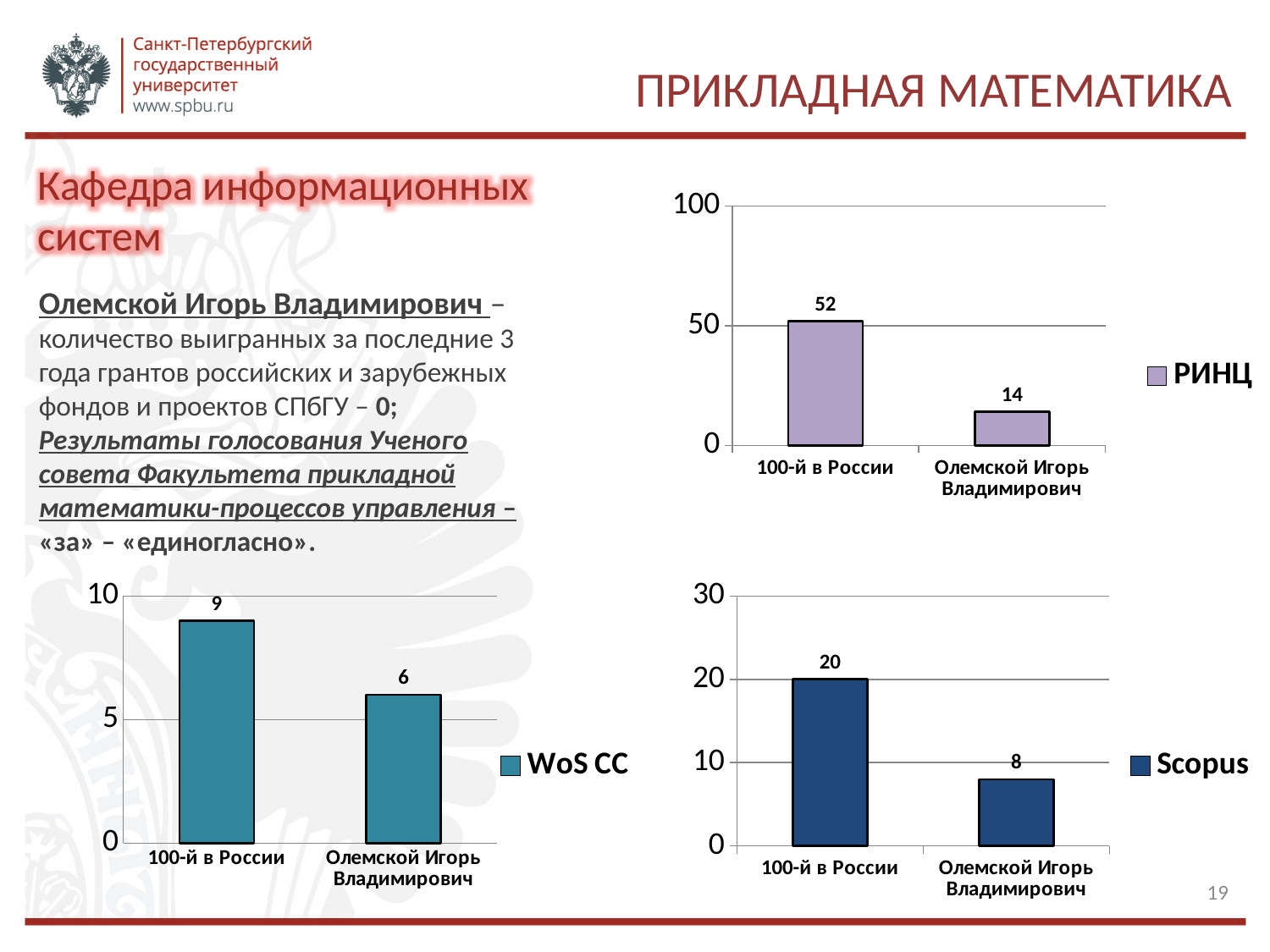
In the Scopus chart (bottom right), what is the value for Олемской Игорь Владимирович? 8 In the РИНЦ chart (top right), what is the difference between the values for 100-й в России and Олемской Игорь Владимирович? 38 In the WoS CC chart (bottom left), what is the value for 100-й в России? 9 In the Scopus chart (bottom right), what is the value for 100-й в России? 20 In the WoS CC chart (bottom left), which category has the highest value? 100-й в России In the РИНЦ chart (top right), what is the value for Олемской Игорь Владимирович? 14 In the WoS CC chart (bottom left), what is the value for Олемской Игорь Владимирович? 6 What kind of chart is the WoS CC chart (bottom left)? Bar chart In the РИНЦ chart (top right), what is the value for 100-й в России? 52 In the Scopus chart (bottom right), which category has the lowest value? Олемской Игорь Владимирович How many categories are shown in the РИНЦ chart (top right)? 2 In the Scopus chart (bottom right), what is the difference between the values for 100-й в России and Олемской Игорь Владимирович? 12